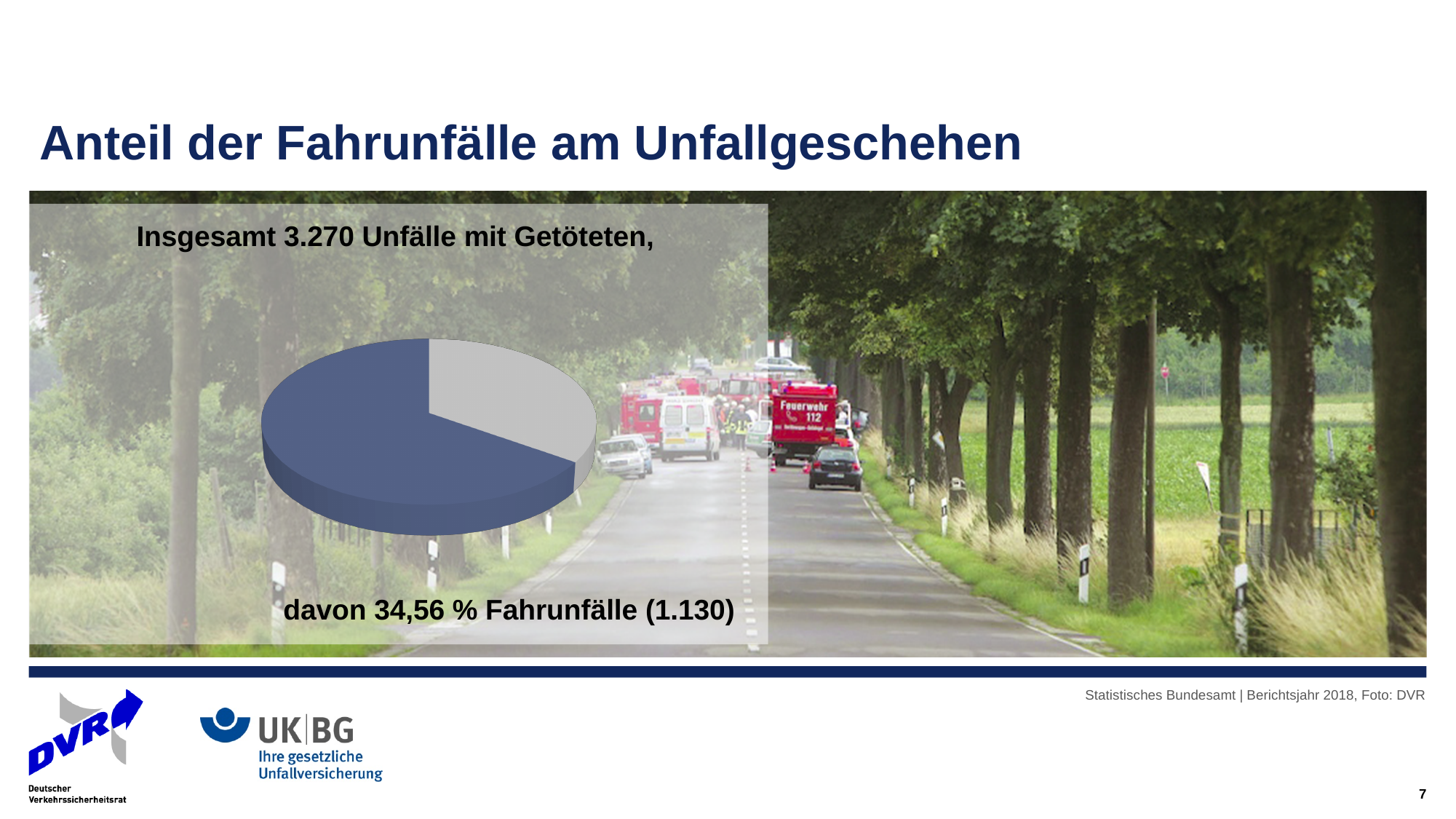
What kind of chart is shown on the slide? pie chart What is the title of the slide containing the pie chart? Anteil der Fahrunfälle am Unfallgeschehen What is the total number of accidents with fatalities (Unfälle mit Getöteten) stated on the slide? 3.270 Is the share of Fahrunfälle greater or less than 50 %? less How many Fahrunfälle are stated on the slide? 1.130 Which slice of the pie chart is larger, the dark blue one or the grey one? the dark blue one Which reporting year (Berichtsjahr) is given as the data source for the chart? 2018 How many of the 3.270 accidents with fatalities are not Fahrunfälle? 2.140 What share of the accidents with fatalities are Fahrunfälle according to the slide? 34,56 % How many slices does the pie chart have? 2